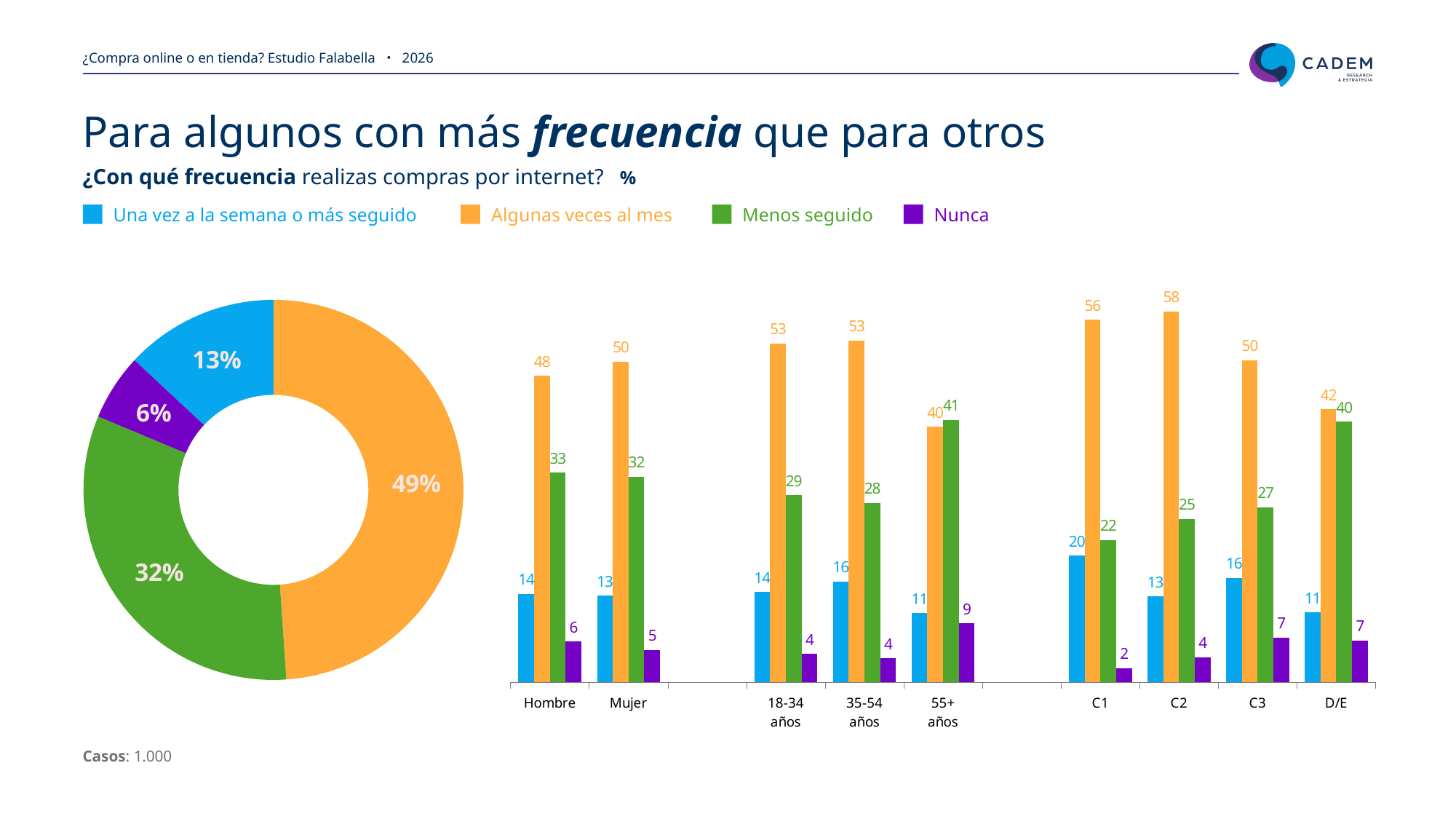
In the bar chart on the right, what is the value of 'Nunca' for C1? 2 In the bar chart on the right, which group has the highest value for 'Una vez a la semana o más seguido'? C1 How many series does the legend list? 4 What type of chart is shown on the right side of the slide? Bar chart In the bar chart on the right, what is the value of 'Menos seguido' for 55+ años? 41 In the bar chart on the right, what is the difference between the 'Algunas veces al mes' values for Hombre and Mujer? 2 In the bar chart on the right, what is the value of 'Algunas veces al mes' for C2? 58 In the donut chart on the left, what share is shown for 'Algunas veces al mes' (orange)? 49% In the bar chart on the right, which group has the lowest value for 'Algunas veces al mes'? 55+ años In the bar chart on the right, is the 'Menos seguido' value larger for D/E or for C3? D/E In the donut chart on the left, what share is shown for 'Nunca' (purple)? 6% In the donut chart on the left, which category has the largest share? Algunas veces al mes